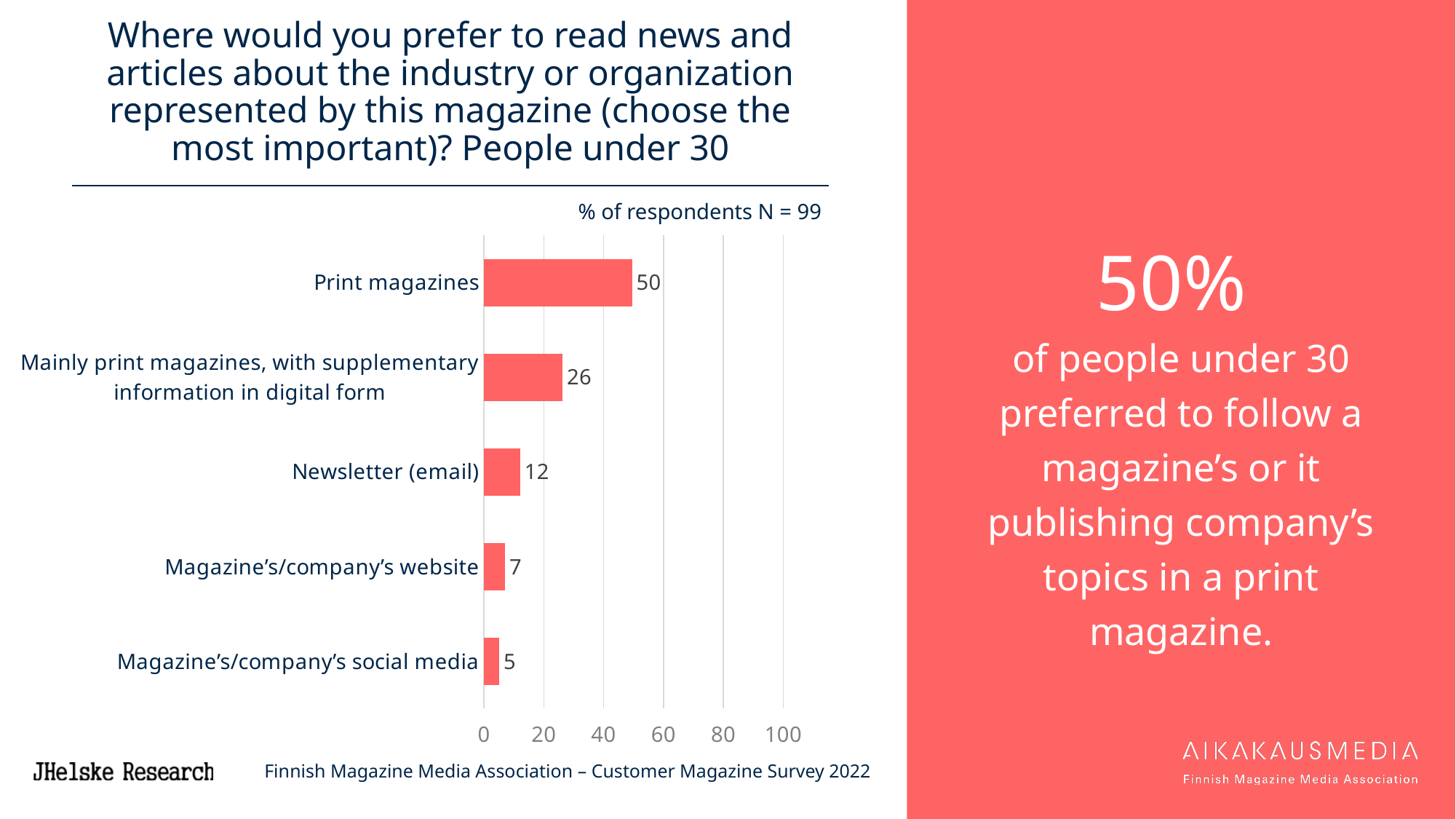
Which category has the highest value? Print magazines What is the difference between the values for Print magazines and Newsletter (email)? 38 Which category has the lowest value? Magazine's/company's social media What kind of chart is shown on the slide? bar chart How many categories are shown in the chart? 5 What is the value for Mainly print magazines, with supplementary information in digital form? 26 What is the value for Magazine's/company's social media? 5 What is the value for Newsletter (email)? 12 What is the number of respondents (N) stated above the chart? 99 What is the value for Print magazines? 50 Is the value for Mainly print magazines, with supplementary information in digital form greater or less than 40? less Which is larger, the value for Magazine's/company's website or the value for Newsletter (email)? Newsletter (email)